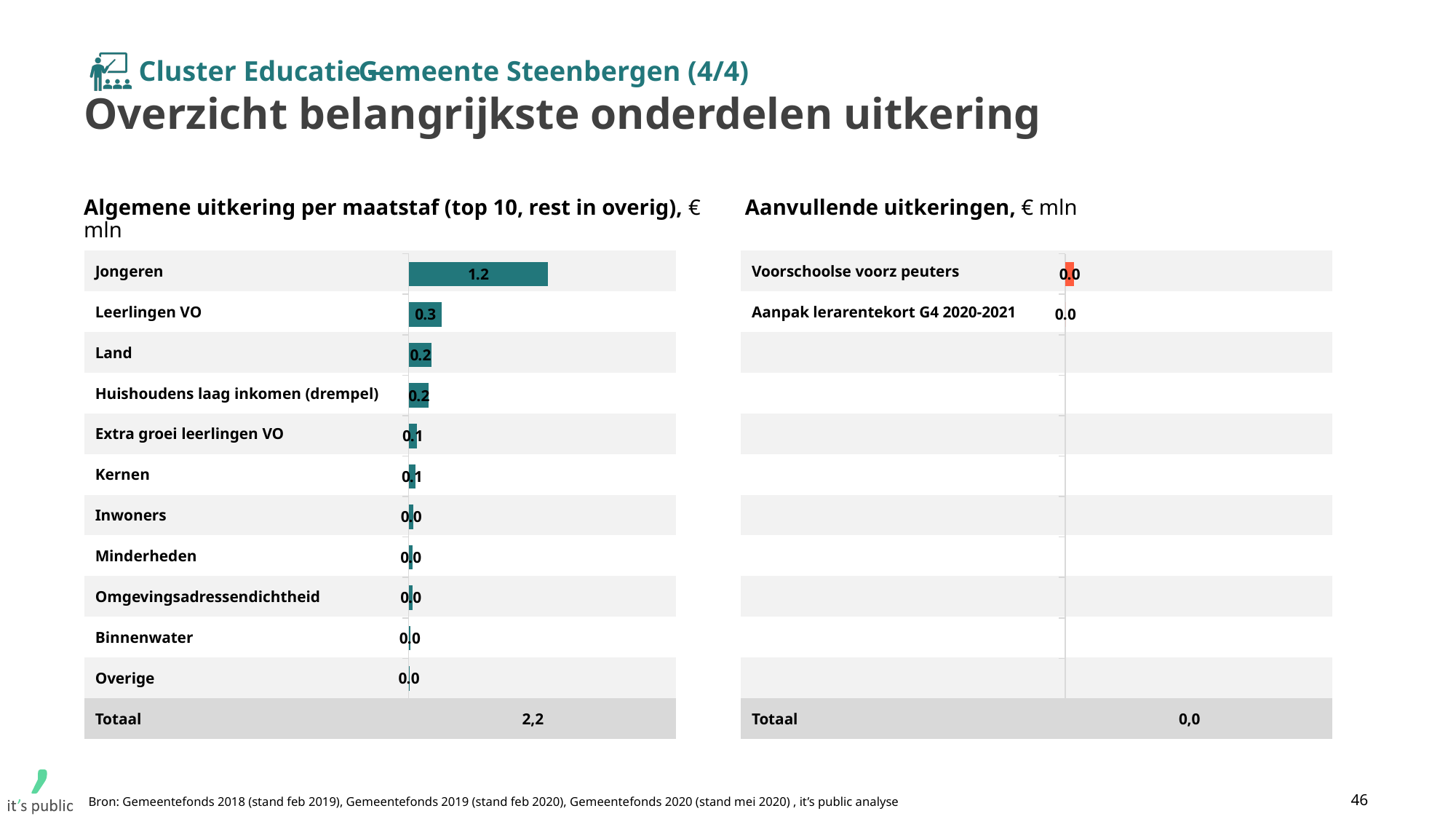
In the chart 'Algemene uitkering per maatstaf (top 10, rest in overig)', what is the value for Huishoudens laag inkomen (drempel)? 0.2 In the chart 'Algemene uitkering per maatstaf (top 10, rest in overig)', what is the difference between the values for Jongeren and Leerlingen VO? 0.9 What kind of chart is 'Aanvullende uitkeringen'? Bar chart In the chart 'Algemene uitkering per maatstaf (top 10, rest in overig)', what is the value for Kernen? 0.1 In the chart 'Algemene uitkering per maatstaf (top 10, rest in overig)', which is larger: the value for Leerlingen VO or the value for Land? Leerlingen VO How many categories are shown in the chart 'Algemene uitkering per maatstaf (top 10, rest in overig)'? 11 In the chart 'Algemene uitkering per maatstaf (top 10, rest in overig)', which category has the highest value? Jongeren What is the Totaal shown for the chart 'Algemene uitkering per maatstaf (top 10, rest in overig)'? 2,2 In the chart 'Algemene uitkering per maatstaf (top 10, rest in overig)', what is the value for Jongeren? 1.2 In the chart 'Algemene uitkering per maatstaf (top 10, rest in overig)', what is the value for Leerlingen VO? 0.3 How many categories are shown in the chart 'Aanvullende uitkeringen'? 2 In the chart 'Aanvullende uitkeringen', what is the value for Aanpak lerarentekort G4 2020-2021? 0.0